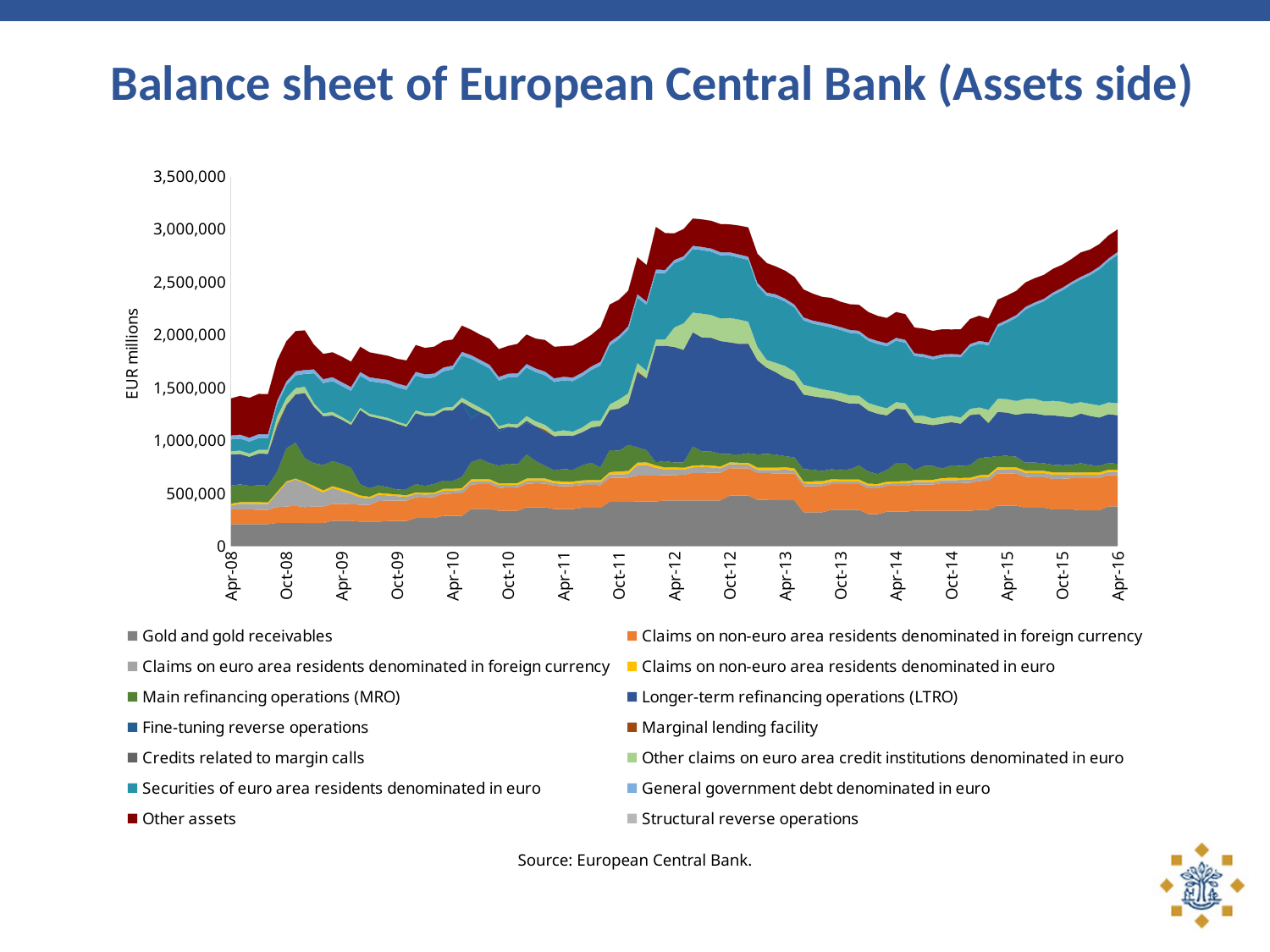
What kind of chart is shown on the slide? Stacked area chart What unit is shown on the vertical axis label? EUR millions Is the total of all stacked series at Oct-09 greater or less than 2,000,000? less Is the total of all stacked series at Apr-14 greater or less than 2,000,000? greater Which is larger, the total of all stacked series at Apr-12 or at Apr-08? Apr-12 How many date labels are shown along the x axis? 17 Is the total of all stacked series at Apr-15 greater or less than 2,000,000? greater Does the total of all stacked series rise or fall between Oct-12 and Apr-14? fall Does the total of all stacked series rise or fall between Oct-14 and Apr-16? rise How many series does the legend list? 14 What is the title of the chart? Balance sheet of European Central Bank (Assets side)